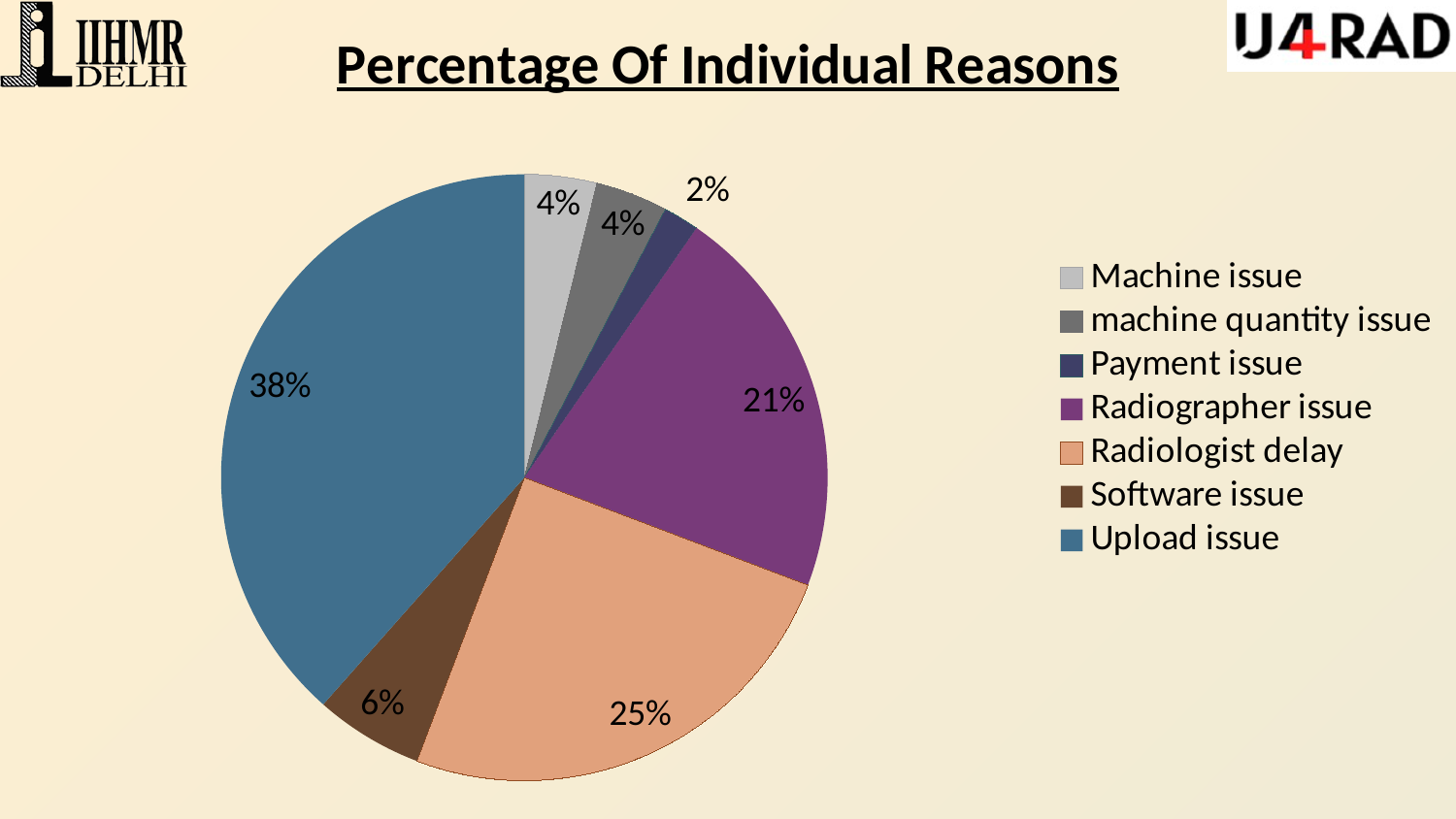
What percentage does the Radiographer issue slice represent? 21% What is the title of the chart? Percentage Of Individual Reasons How many categories does the legend list? 7 Which is larger, the Radiographer issue slice or the Radiologist delay slice? Radiologist delay Which reason has the largest share of the pie? Upload issue What percentage does the Radiologist delay slice represent? 25% What is the difference in percentage points between Upload issue and Radiologist delay? 13 What percentage does the Payment issue slice represent? 2% What percentage does the Software issue slice represent? 6% Which reason has the smallest share of the pie? Payment issue What percentage does the Upload issue slice represent? 38% What type of chart is shown on the slide? pie chart